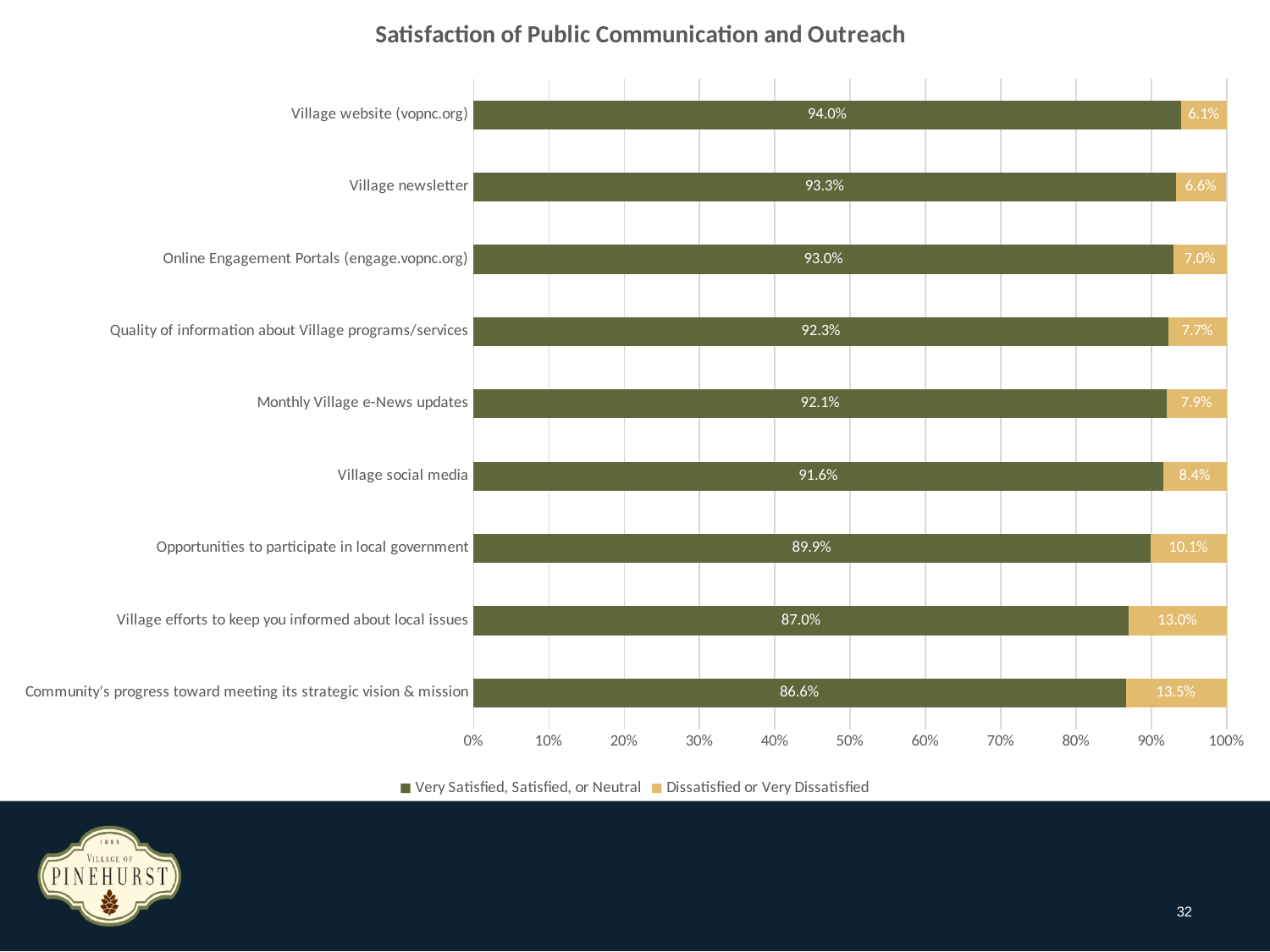
Which has a larger 'Dissatisfied or Very Dissatisfied' value: Opportunities to participate in local government or Village social media? Opportunities to participate in local government What is the 'Dissatisfied or Very Dissatisfied' value for Village efforts to keep you informed about local issues? 13.0% What is the 'Very Satisfied, Satisfied, or Neutral' value for Monthly Village e-News updates? 92.1% Which category has the highest 'Very Satisfied, Satisfied, or Neutral' value? Village website (vopnc.org) How many categories are shown on the chart? 9 What is the difference between the 'Very Satisfied, Satisfied, or Neutral' values for Village newsletter and Village social media? 1.7% What kind of chart is shown on the slide? Stacked bar chart Which category has the highest 'Dissatisfied or Very Dissatisfied' value? Community's progress toward meeting its strategic vision & mission What is the 'Very Satisfied, Satisfied, or Neutral' value for Village website (vopnc.org)? 94.0% How many series does the legend list? 2 What is the title of the chart? Satisfaction of Public Communication and Outreach Which category has the lowest 'Very Satisfied, Satisfied, or Neutral' value? Community's progress toward meeting its strategic vision & mission